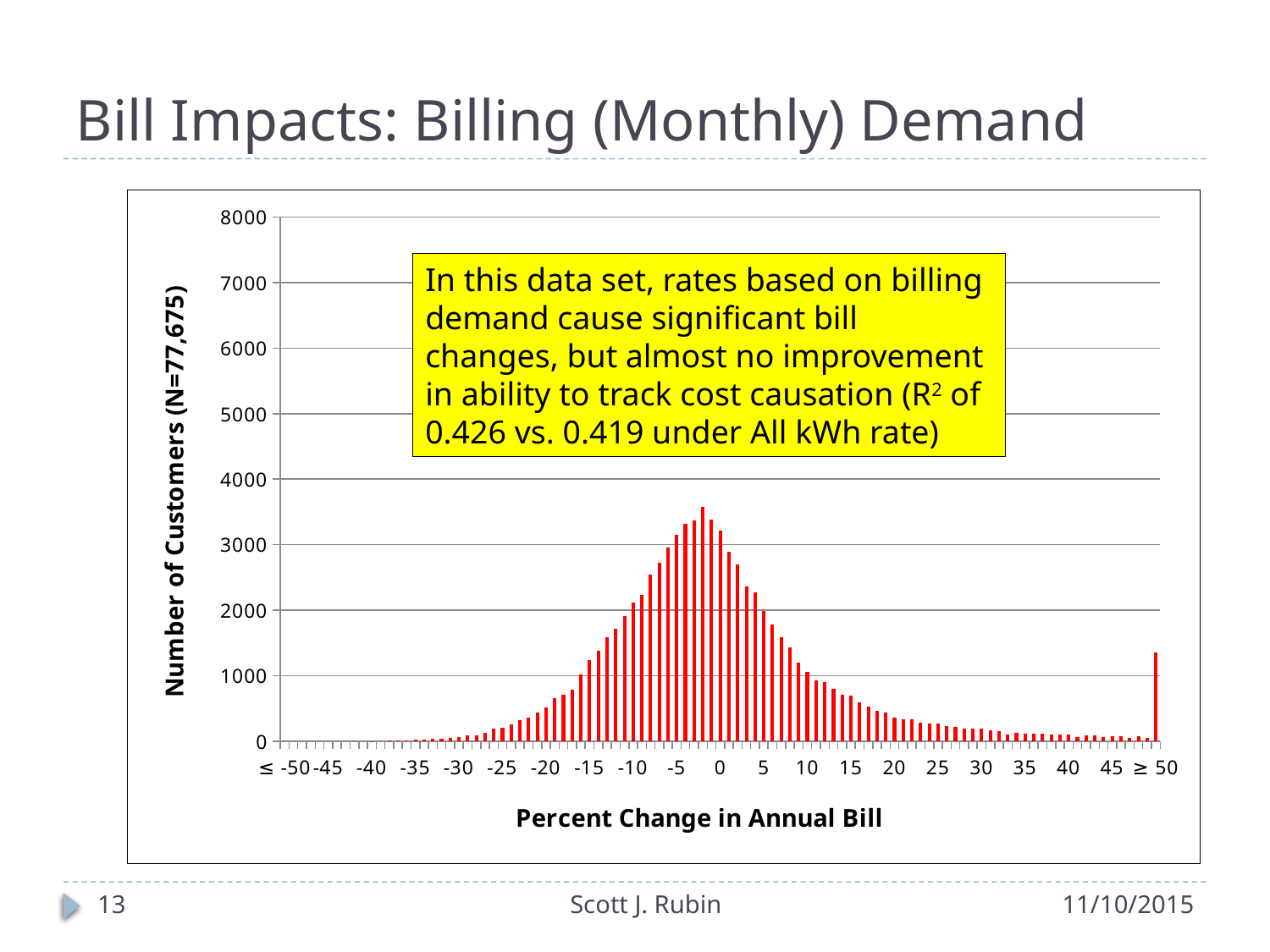
Is the number of customers at a 0 percent change greater or less than 2000? greater What kind of chart is shown on the slide? bar chart Is the number of customers at the ≥ 50 percent change greater or less than 1000? greater Is the number of customers at a -5 percent change greater or less than 2000? greater Which has more customers: the 45 percent change or the ≥ 50 percent change? ≥ 50 What is the title of the y axis? Number of Customers (N=77,675) What is the title of the x axis? Percent Change in Annual Bill Do the bar heights rise or fall as the percent change goes from 0 to 45? fall Which has more customers: the -5 percent change or the 20 percent change? -5